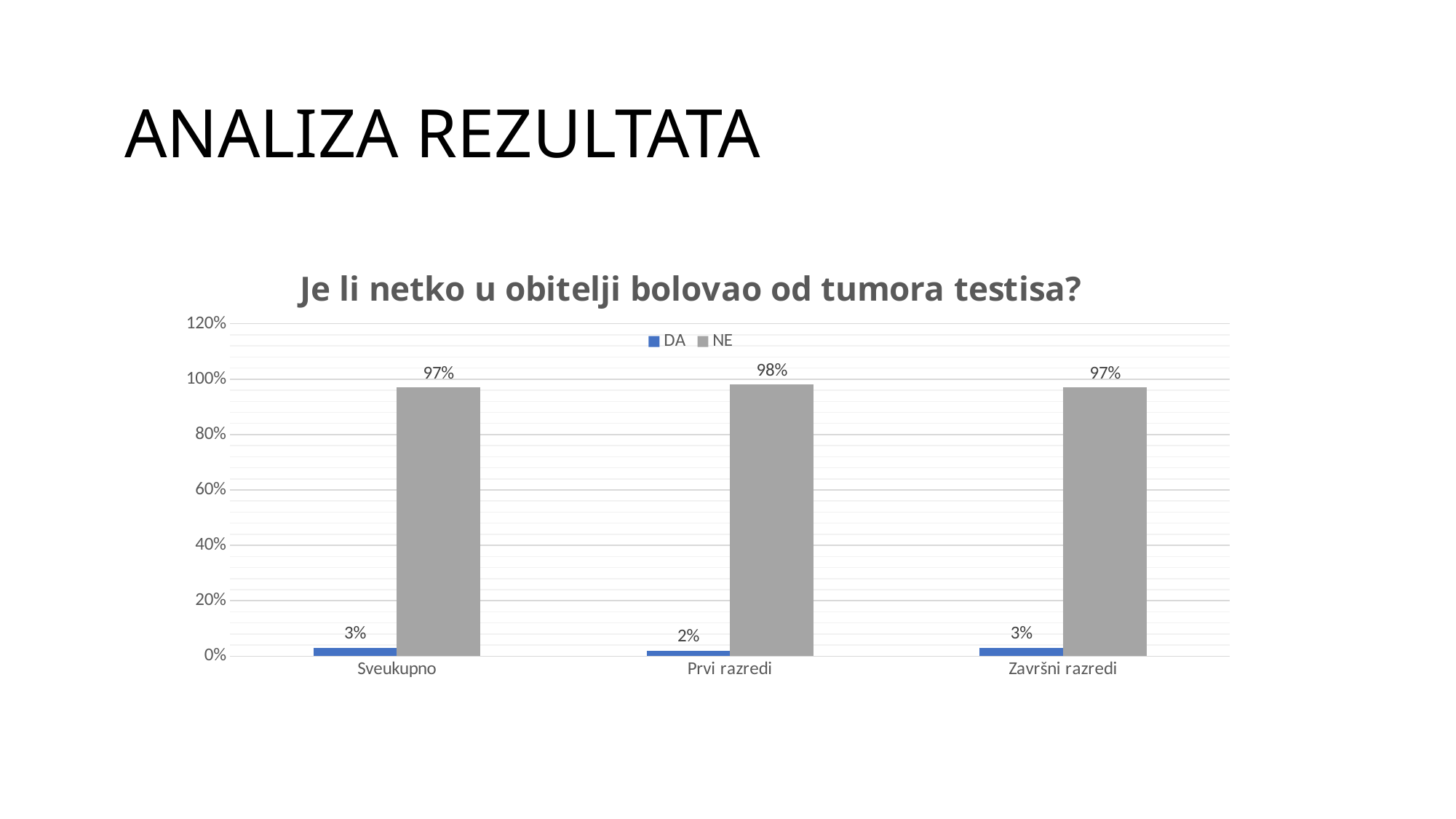
Which is larger in the Prvi razredi category, DA or NE? NE How many series does the legend list? 2 What is the value for DA in the Završni razredi category? 3% What is the difference between the NE and DA values in the Sveukupno category? 94% What is the value for NE in the Sveukupno category? 97% What kind of chart is shown on the slide? Bar chart How many categories are shown on the x axis? 3 What is the value for DA in the Prvi razredi category? 2% What is the title of the chart? Je li netko u obitelji bolovao od tumora testisa? What is the value for NE in the Završni razredi category? 97% Which category has the highest value for NE? Prvi razredi Which category has the lowest value for DA? Prvi razredi